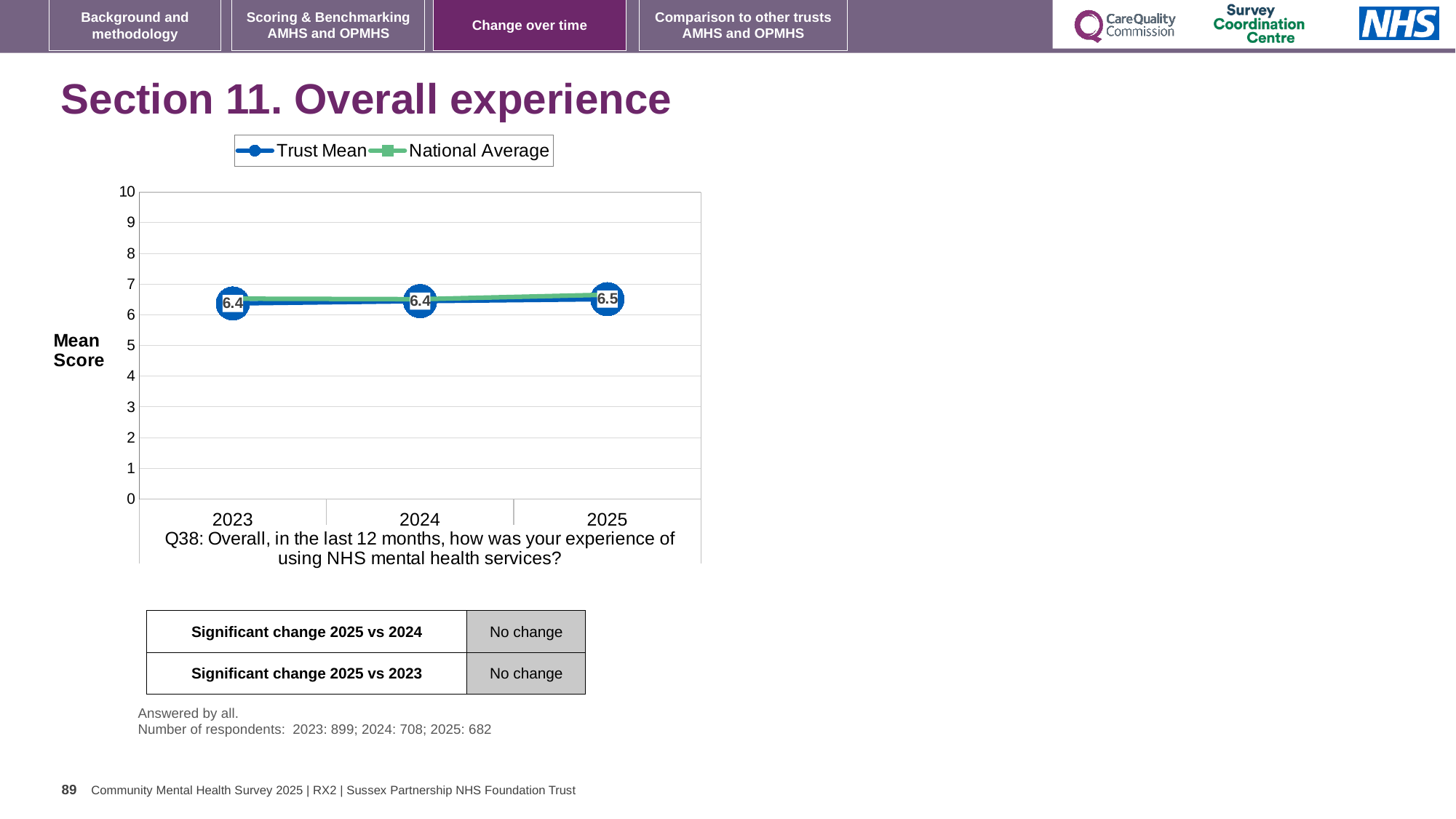
In which year is the Trust Mean highest? 2025 How many series does the legend list? 2 Is the Trust Mean for 2025 larger than the Trust Mean for 2024? Yes Is the National Average value for 2025 greater or less than 5? greater What is the Trust Mean value for 2023? 6.4 What is the Trust Mean value for 2025? 6.5 What is the Trust Mean value for 2024? 6.4 What is the label on the y axis of the chart? Mean Score How many years are plotted on the x axis? 3 Is the Trust Mean value for 2023 greater or less than 8? less What is the difference between the Trust Mean in 2025 and in 2023? 0.1 What kind of chart is shown on the slide? Line chart